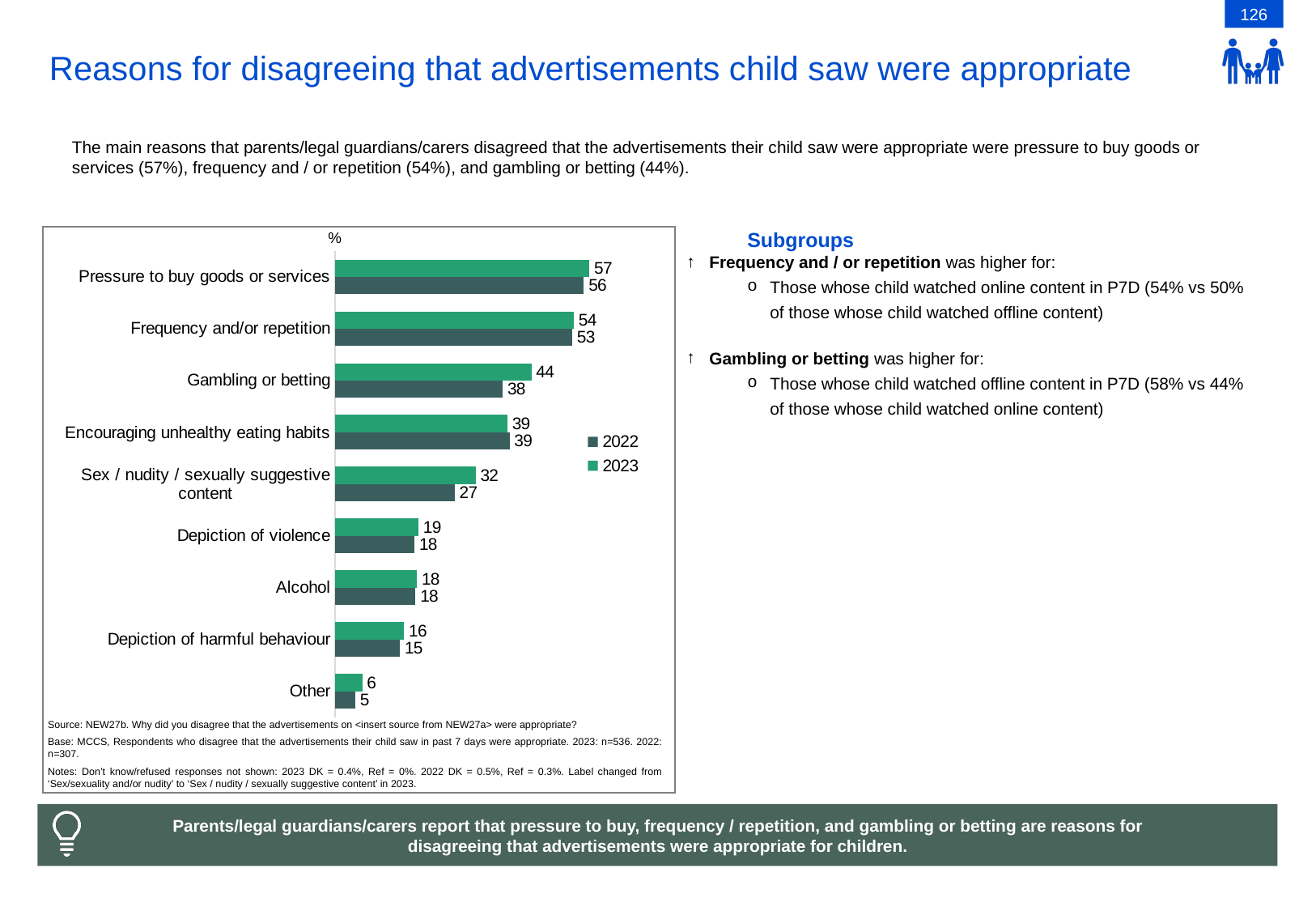
Which category has the lowest 2022 value? Other What is the difference between the 2023 and 2022 values for Gambling or betting? 6 What is the 2022 value for Sex / nudity / sexually suggestive content? 27 What is the 2023 value for Gambling or betting? 44 What is the 2023 value for Depiction of harmful behaviour? 16 What kind of chart is shown on the slide? Bar chart How many series does the legend list? 2 What is the 2022 value for Alcohol? 18 Which series is shown in green in the legend? 2023 Which category has the highest 2023 value? Pressure to buy goods or services Which is larger for Sex / nudity / sexually suggestive content, the 2023 value or the 2022 value? 2023 How many categories are shown in the chart? 9